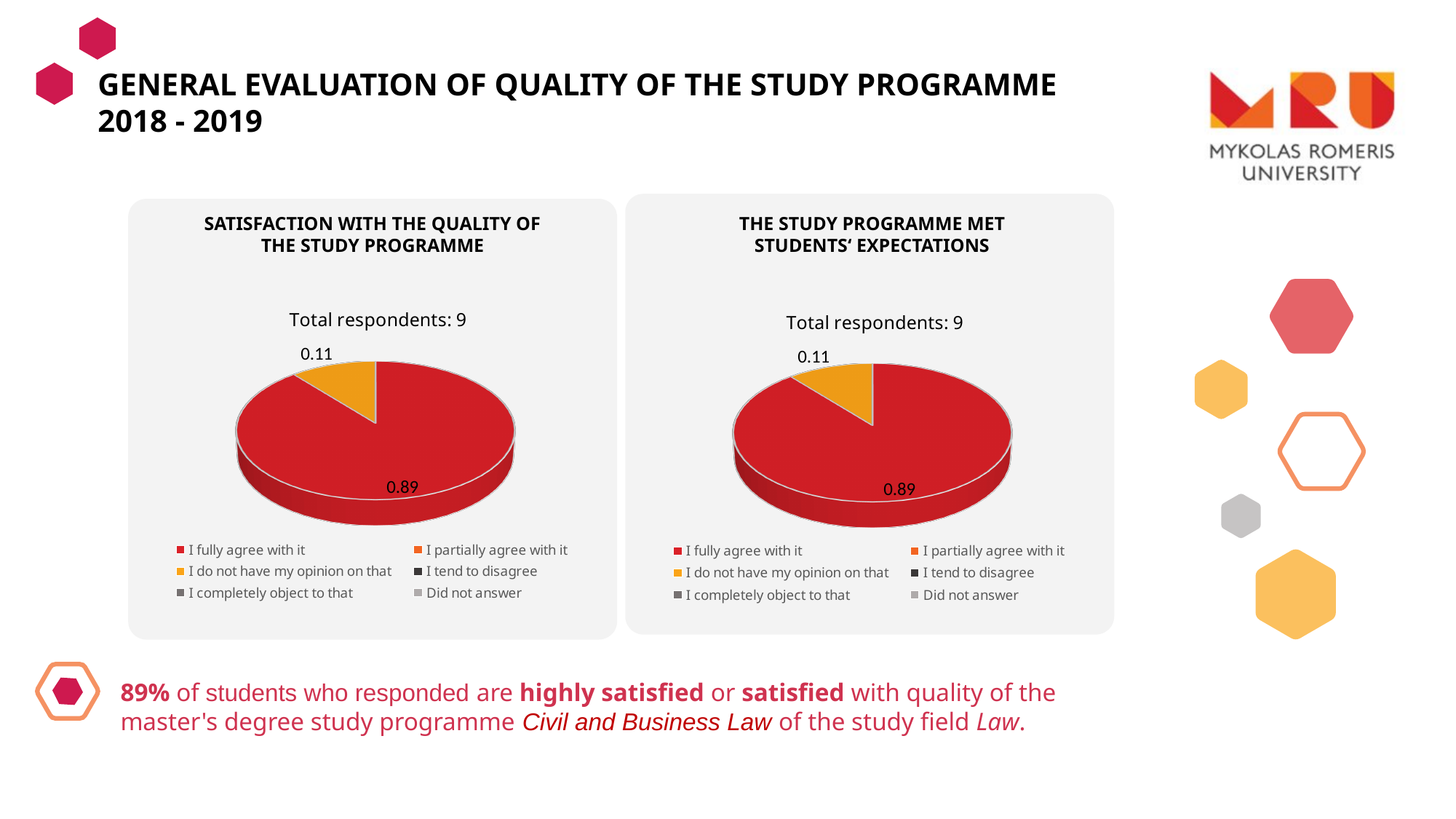
In the chart titled 'Satisfaction with the quality of the study programme', what share of respondents chose 'I fully agree with it'? 0.89 What type of chart is used in the left panel, 'Satisfaction with the quality of the study programme'? Pie chart In the chart titled 'The study programme met students' expectations', what value is shown for 'I do not have my opinion on that'? 0.11 In the chart titled 'The study programme met students' expectations', what value is shown for 'I fully agree with it'? 0.89 How many total respondents are reported for the chart titled 'Satisfaction with the quality of the study programme'? 9 In the chart titled 'The study programme met students' expectations', which response category has the smallest visible slice? I do not have my opinion on that In the chart titled 'Satisfaction with the quality of the study programme', what value is shown for the 'I do not have my opinion on that' slice? 0.11 How many slices are visible in the pie chart titled 'The study programme met students' expectations'? 2 In the chart titled 'Satisfaction with the quality of the study programme', which response category has the largest slice? I fully agree with it How many entries does the legend list in the chart titled 'Satisfaction with the quality of the study programme'? 6 In the chart titled 'Satisfaction with the quality of the study programme', what is the difference between the 'I fully agree with it' value and the 'I do not have my opinion on that' value? 0.78 In the chart titled 'The study programme met students' expectations', which is larger: 'I fully agree with it' or 'I do not have my opinion on that'? I fully agree with it